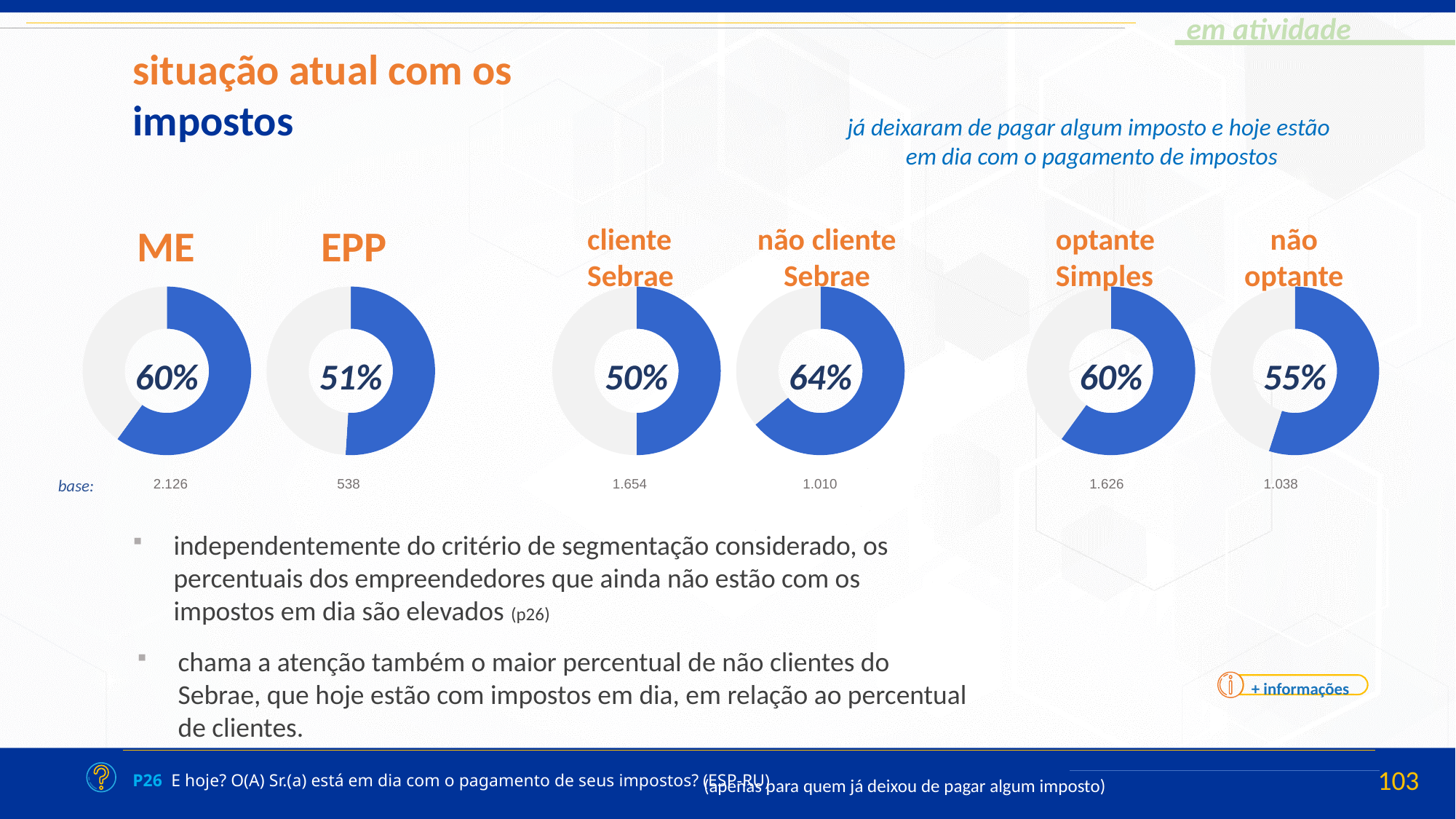
How many donut charts are shown on the slide? 6 What is the difference in percentage points between the 'não cliente Sebrae' and 'cliente Sebrae' donut charts? 14 What kind of chart is used to display the percentages on the slide? Donut chart Which shows a larger percentage, the 'optante Simples' chart or the 'não optante' chart? optante Simples Which of the six donut charts shows the highest percentage? não cliente Sebrae What percentage is shown in the 'não optante' donut chart? 55% What is the base (sample size) shown under the ME donut chart? 2.126 What percentage is shown in the 'não cliente Sebrae' donut chart? 64% What percentage is shown in the ME donut chart? 60% Which of the six donut charts shows the lowest percentage? cliente Sebrae What is the base (sample size) shown under the 'cliente Sebrae' donut chart? 1.654 What percentage is shown in the EPP donut chart? 51%